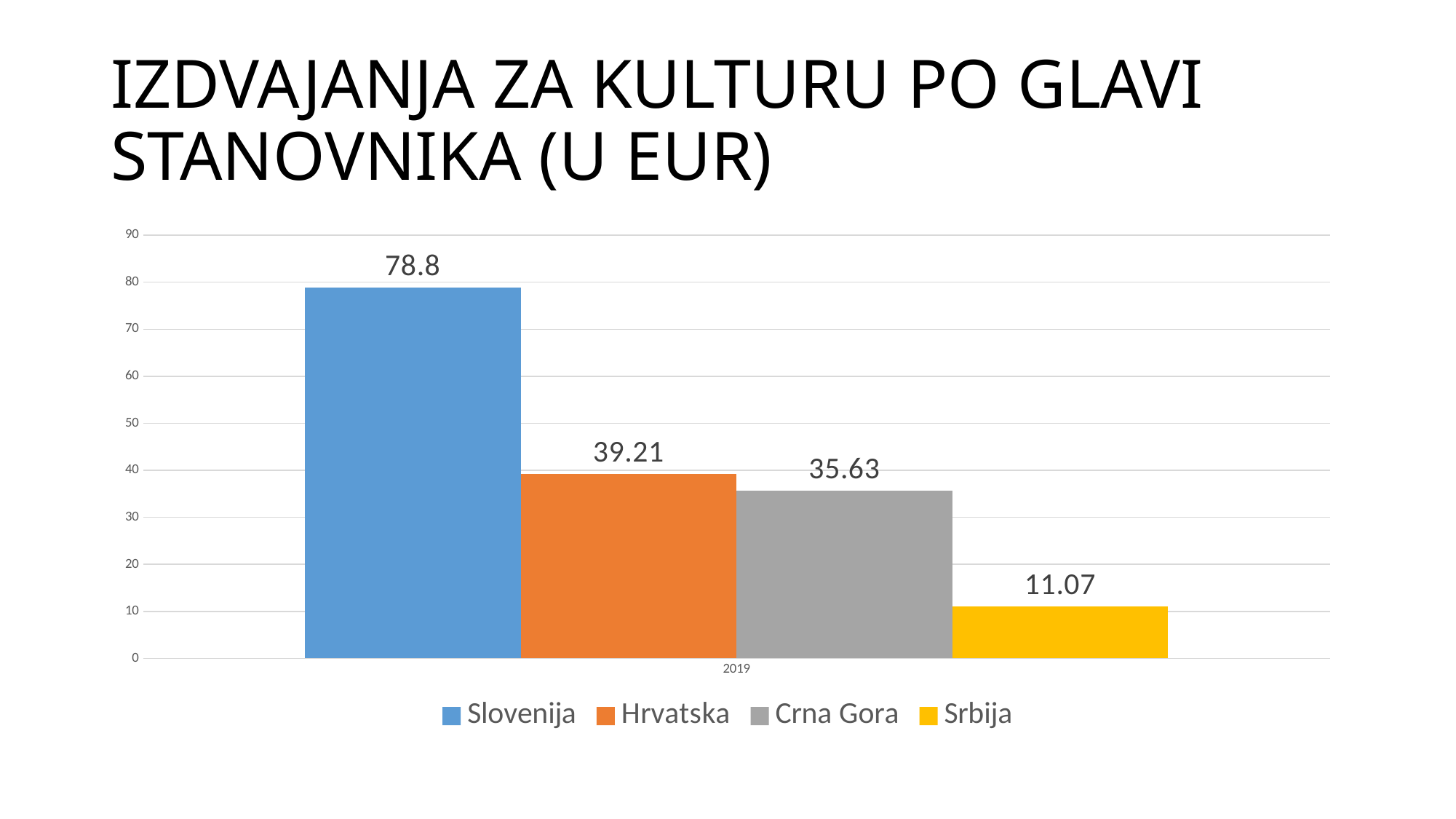
What is the difference between the values for Slovenija and Hrvatska? 39.59 Which series has the lowest value? Srbija What is the difference between the values for Crna Gora and Srbija? 24.56 What is the value for Slovenija? 78.8 What kind of chart is shown on the slide? Bar chart How many series does the legend list? 4 Which is larger, the value for Hrvatska or the value for Crna Gora? Hrvatska What is the value for Srbija? 11.07 What year is shown on the x axis of the chart? 2019 What is the value for Hrvatska? 39.21 Which series has the highest value? Slovenija What is the value for Crna Gora? 35.63